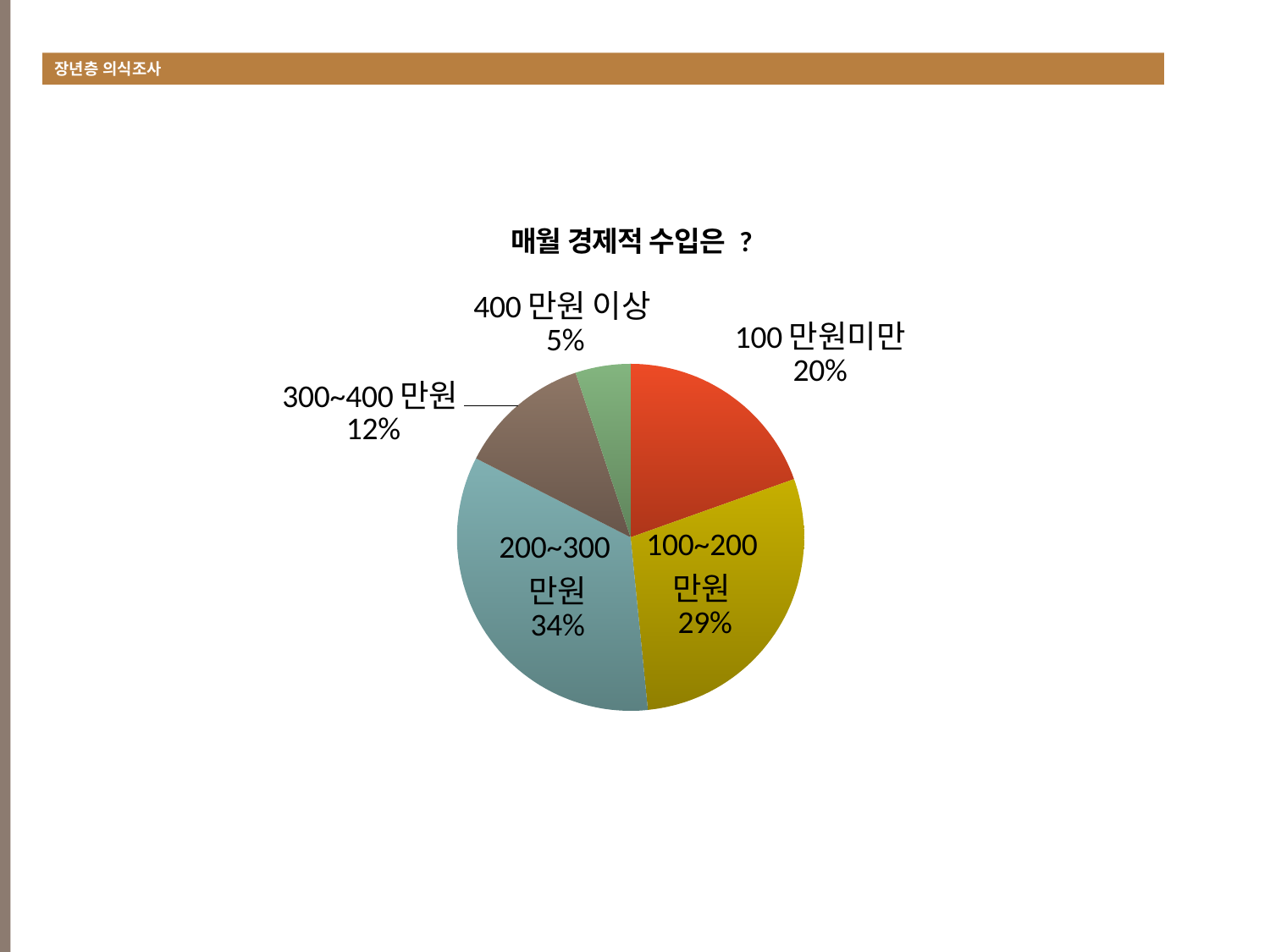
What is the title of the chart? 매월 경제적 수입은 ? What kind of chart is shown on the slide? Pie chart What share of the pie does the 200~300 만원 slice represent? 34% Which category has the largest slice of the pie? 200~300 만원 What is the value shown for 300~400 만원? 12% What is the difference between the 100 만원미만 share and the 400 만원 이상 share? 15% How many categories are shown in the pie chart? 5 Which category has the smallest slice of the pie? 400 만원 이상 Which is larger, the share for 100 만원미만 or the share for 300~400 만원? 100 만원미만 What is the difference between the 200~300 만원 share and the 100~200 만원 share? 5% What is the value shown for 100 만원미만? 20% What is the value shown for 400 만원 이상? 5%